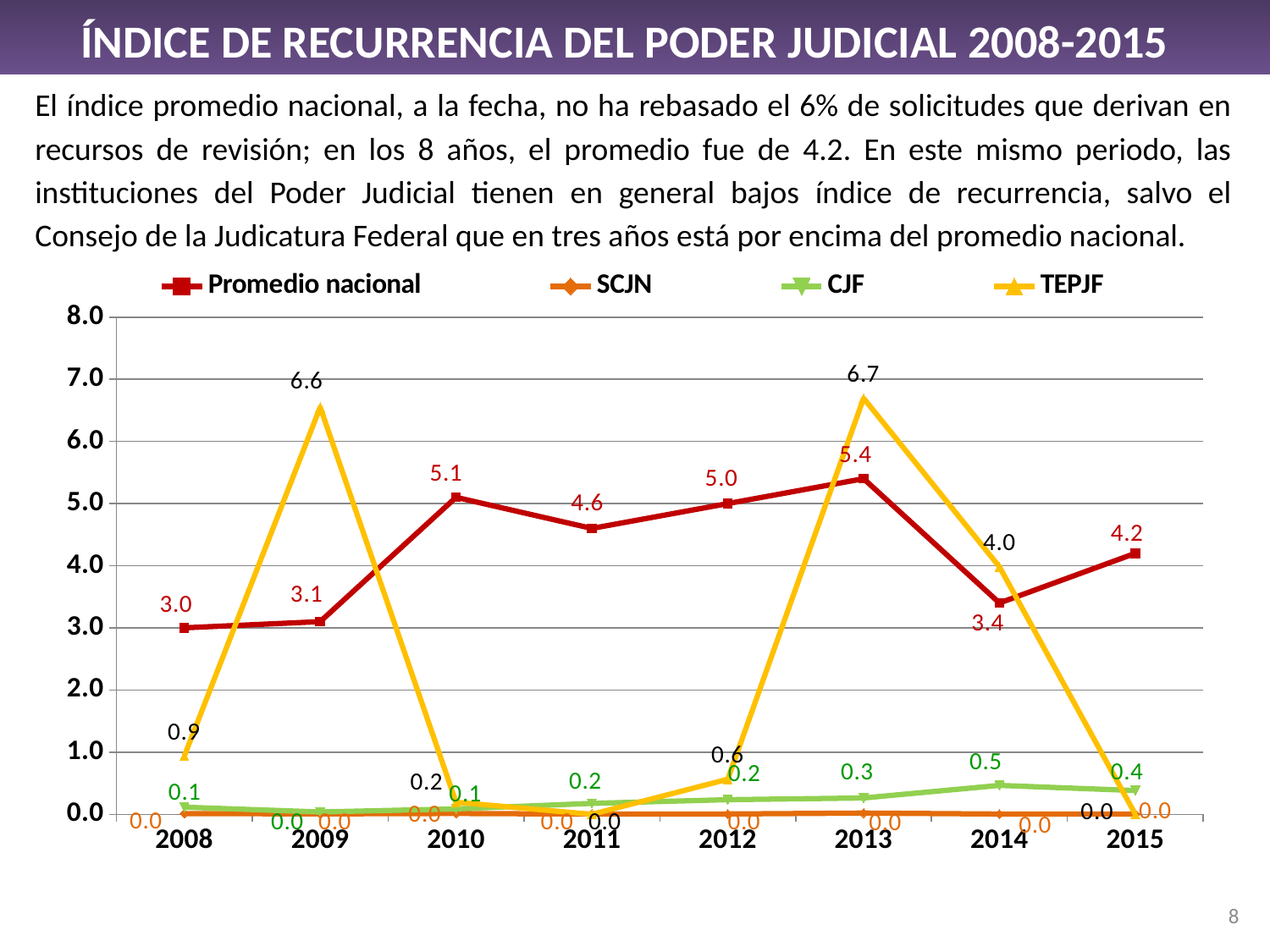
What is the difference between the TEPJF value and the Promedio nacional value in 2013? 1.3 How many series does the legend list? 4 Does Promedio nacional rise or fall from 2014 to 2015? rise In which year does TEPJF reach its highest value? 2013 What is the value of Promedio nacional in 2013? 5.4 How many years are plotted on the x axis? 8 Which is larger in 2014: Promedio nacional or TEPJF? TEPJF What is the value of TEPJF in 2009? 6.6 Which series is drawn in yellow? TEPJF What is the value of CJF in 2014? 0.5 What type of chart is shown on the slide? line chart In which year is Promedio nacional at its lowest? 2008